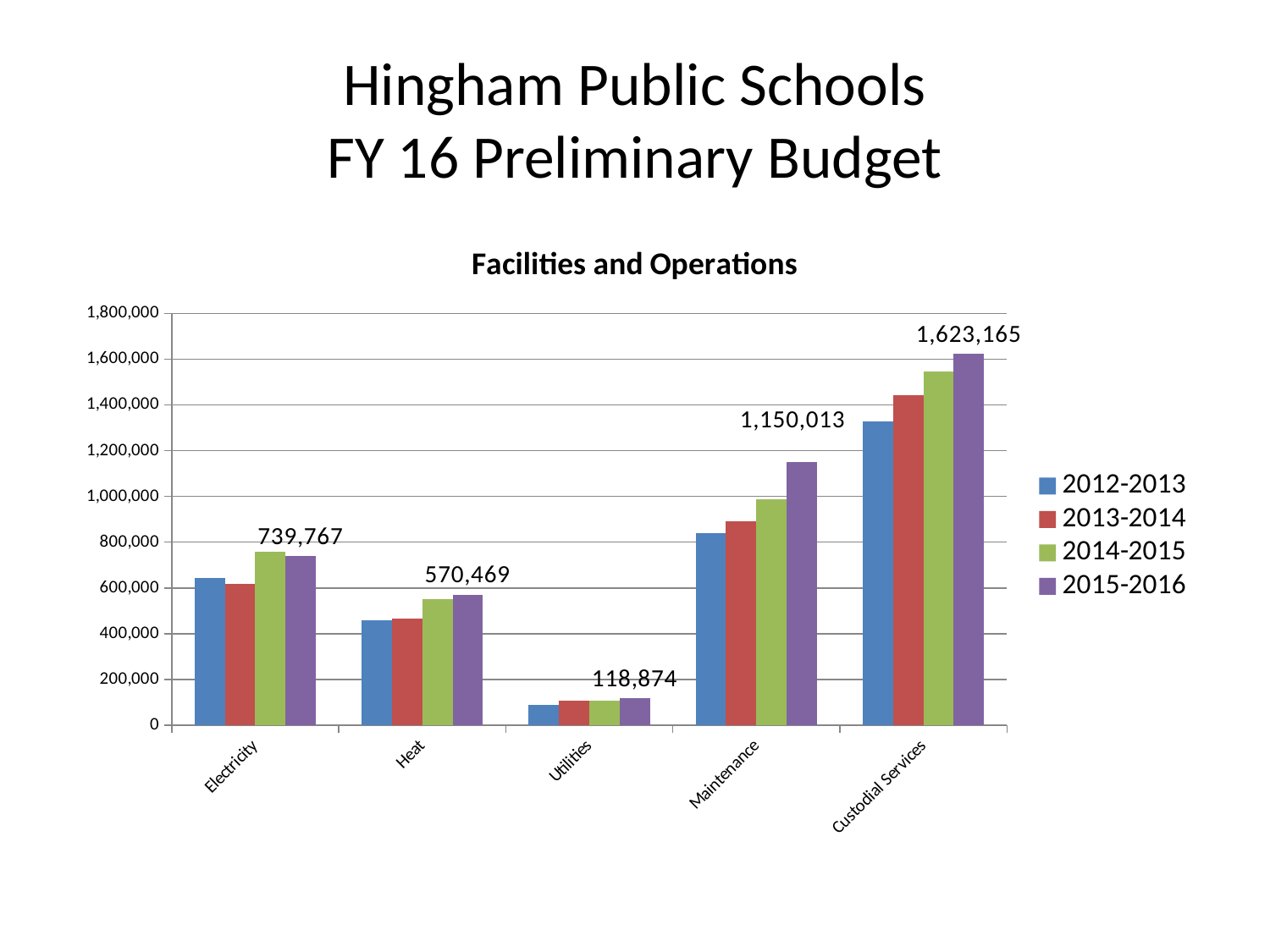
How many series does the legend list? 4 What is the title of the chart on the slide? Facilities and Operations What is the 2015-2016 value for Maintenance? 1,150,013 What is the difference between the 2015-2016 values for Electricity and Heat? 169,298 What type of chart is shown on the slide? bar chart How many categories are shown on the x axis? 5 What is the 2015-2016 value for Utilities? 118,874 Which is larger for Electricity: the 2014-2015 value or the 2013-2014 value? 2014-2015 Is the 2012-2013 value for Maintenance greater or less than 1,000,000? less Which category has the lowest 2015-2016 value? Utilities Which category has the highest 2015-2016 value? Custodial Services What is the 2015-2016 value for Custodial Services? 1,623,165